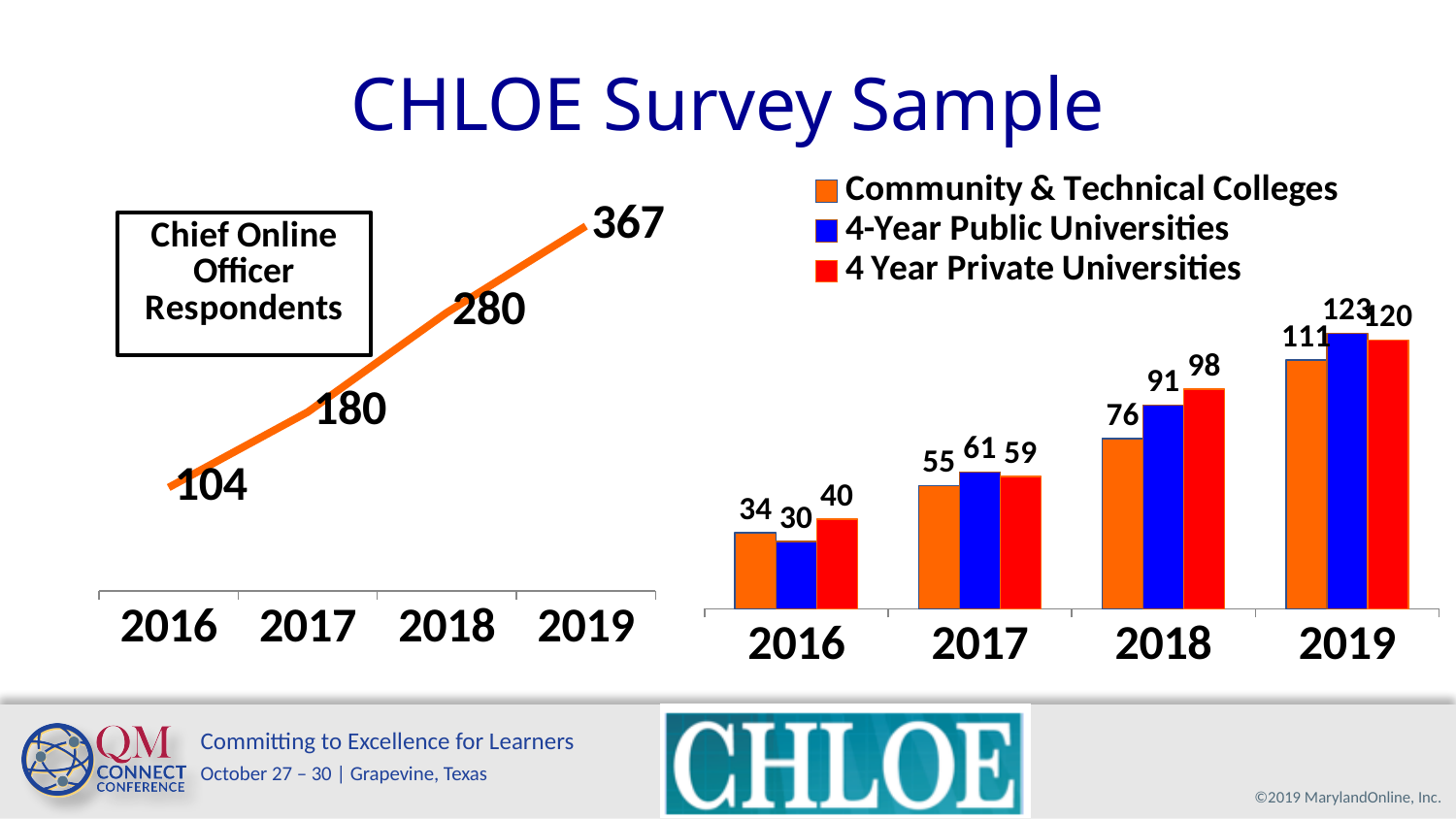
In the right bar chart, what is the value for 4-Year Public Universities in 2018? 91 In the left chart (Chief Online Officer Respondents), what is the value for 2016? 104 In the right bar chart, which year has the highest value for 4 Year Private Universities? 2019 In the right bar chart, what is the value for Community & Technical Colleges in 2016? 34 How many series does the legend of the right bar chart list? 3 In the right bar chart, what is the difference between 4-Year Public Universities and Community & Technical Colleges in 2019? 12 In the right bar chart, which colour represents 4 Year Private Universities? red In the left chart (Chief Online Officer Respondents), do the values rise or fall from 2016 to 2019? rise In the left chart (Chief Online Officer Respondents), what is the difference between the 2018 and 2017 values? 100 In the left chart (Chief Online Officer Respondents), what is the value for 2019? 367 What kind of chart is the left chart (Chief Online Officer Respondents)? line chart In the right bar chart, which series has the lowest value in 2016? 4-Year Public Universities